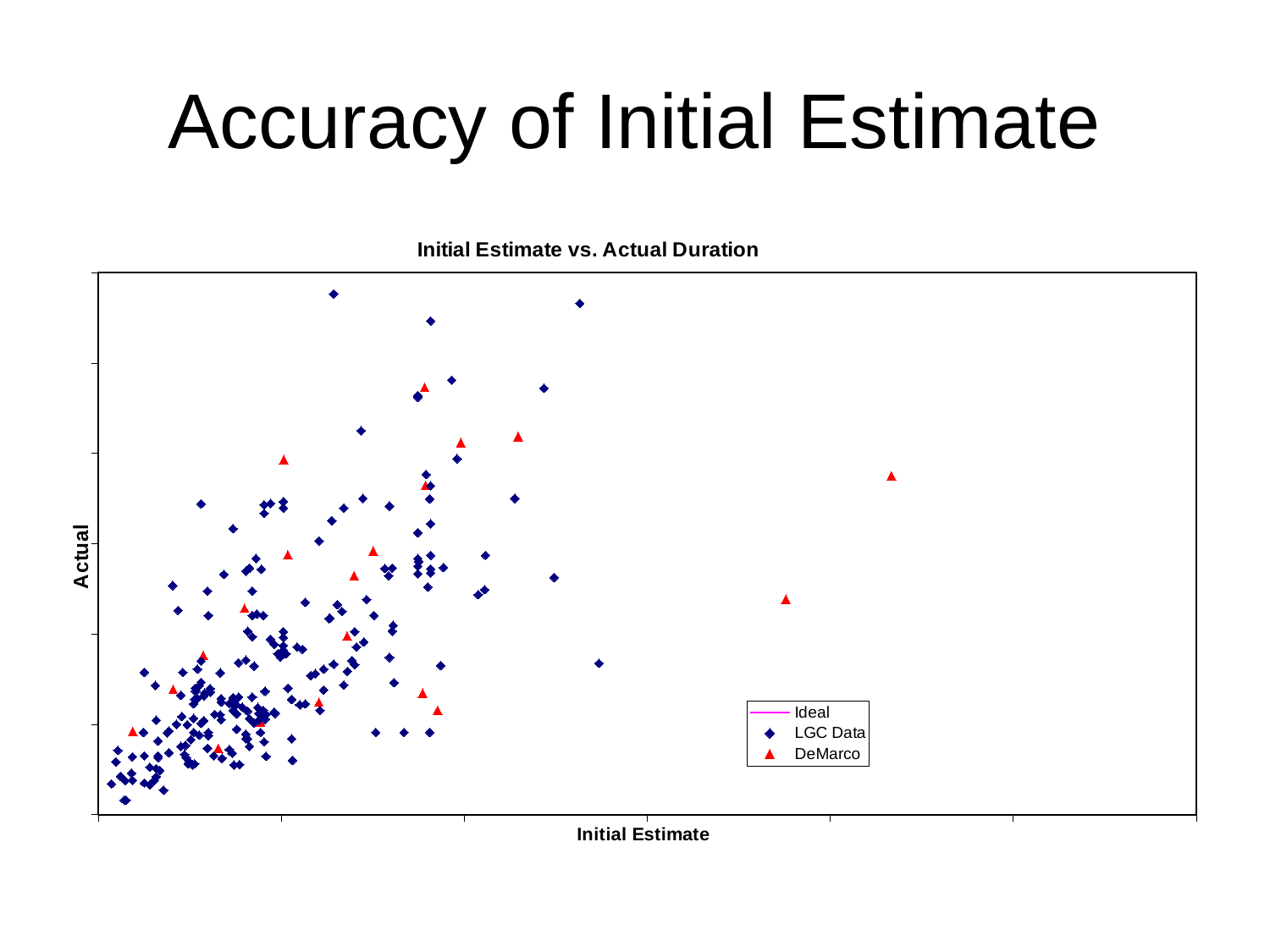
How many series does the legend list? 3 Which series is plotted with red triangles? DeMarco Do the Actual values generally rise or fall as the Initial Estimate increases? Rise What kind of chart is shown on the slide? Scatter chart What is the title of the chart? Initial Estimate vs. Actual Duration